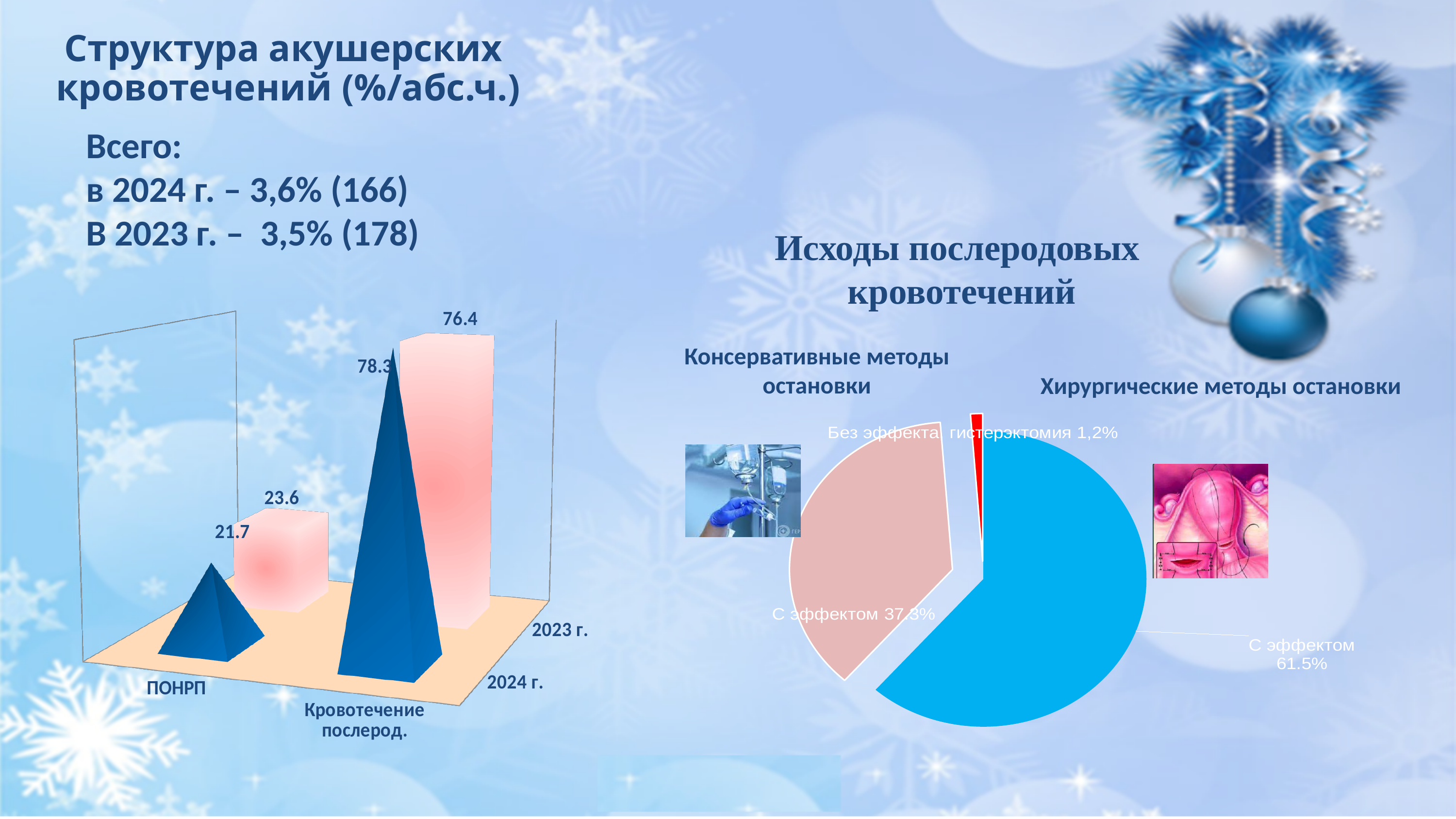
How many categories are shown on the left bar chart? 2 In the pie chart Исходы послеродовых кровотечений, what share is labelled гистерэктомия? 1,2% In the left bar chart, what is the value for ПОНРП in 2023 г.? 23.6 In the left bar chart, which is larger for ПОНРП: the 2023 г. value or the 2024 г. value? 2023 г. What kind of chart is the left chart on the slide? Bar chart In the left bar chart, what is the value for Кровотечение послерод. in 2023 г.? 76.4 In the left bar chart, what is the difference between the 2024 г. and 2023 г. values for Кровотечение послерод.? 1.9 In the pie chart Исходы послеродовых кровотечений, what share is labelled С эффектом under Хирургические методы остановки? 61.5% In the left bar chart, what is the value for Кровотечение послерод. in 2024 г.? 78.3 In the pie chart Исходы послеродовых кровотечений, which is larger: the С эффектом 37.3% slice or the С эффектом 61.5% slice? С эффектом 61.5% In the left bar chart, which category has the highest value in 2024 г.? Кровотечение послерод. In the left bar chart, what is the value for ПОНРП in 2024 г.? 21.7